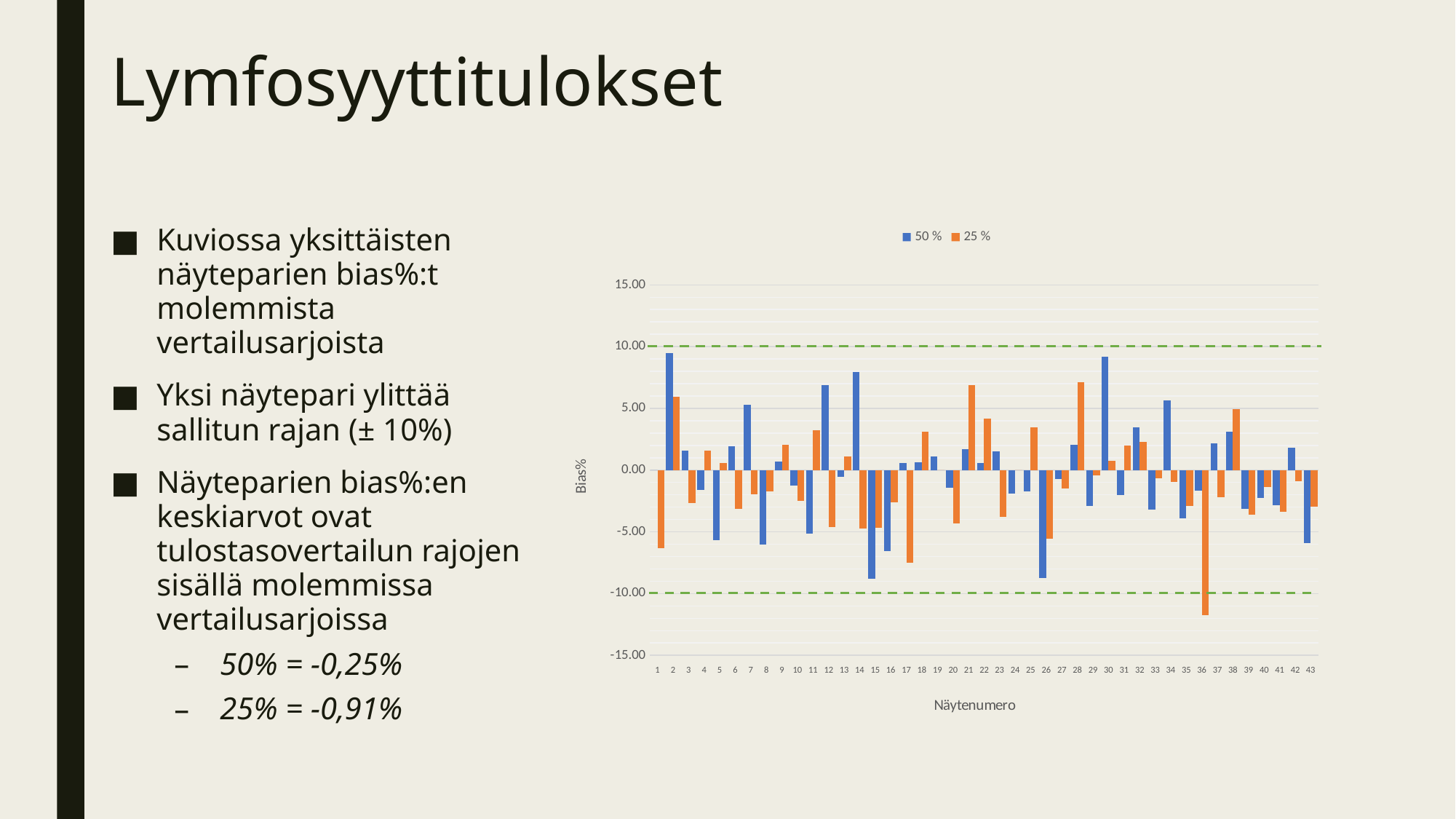
What is the label of the y axis? Bias% How many sample numbers (Näytenumero) are shown along the x axis? 43 Is the 50 % value for sample 26 greater or less than -5.00? less What kind of chart is shown on the slide? bar chart Which colour represents the 25 % series in the chart? orange Is the 50 % value for sample 15 greater or less than -5.00? less Is the 25 % value for sample 36 greater or less than -10.00? less For sample 36, which series has the larger value, 50 % or 25 %? 50 % How many series does the chart legend list? 2 Which series has the lowest value in the chart, and at which sample number? 25 % at sample 36